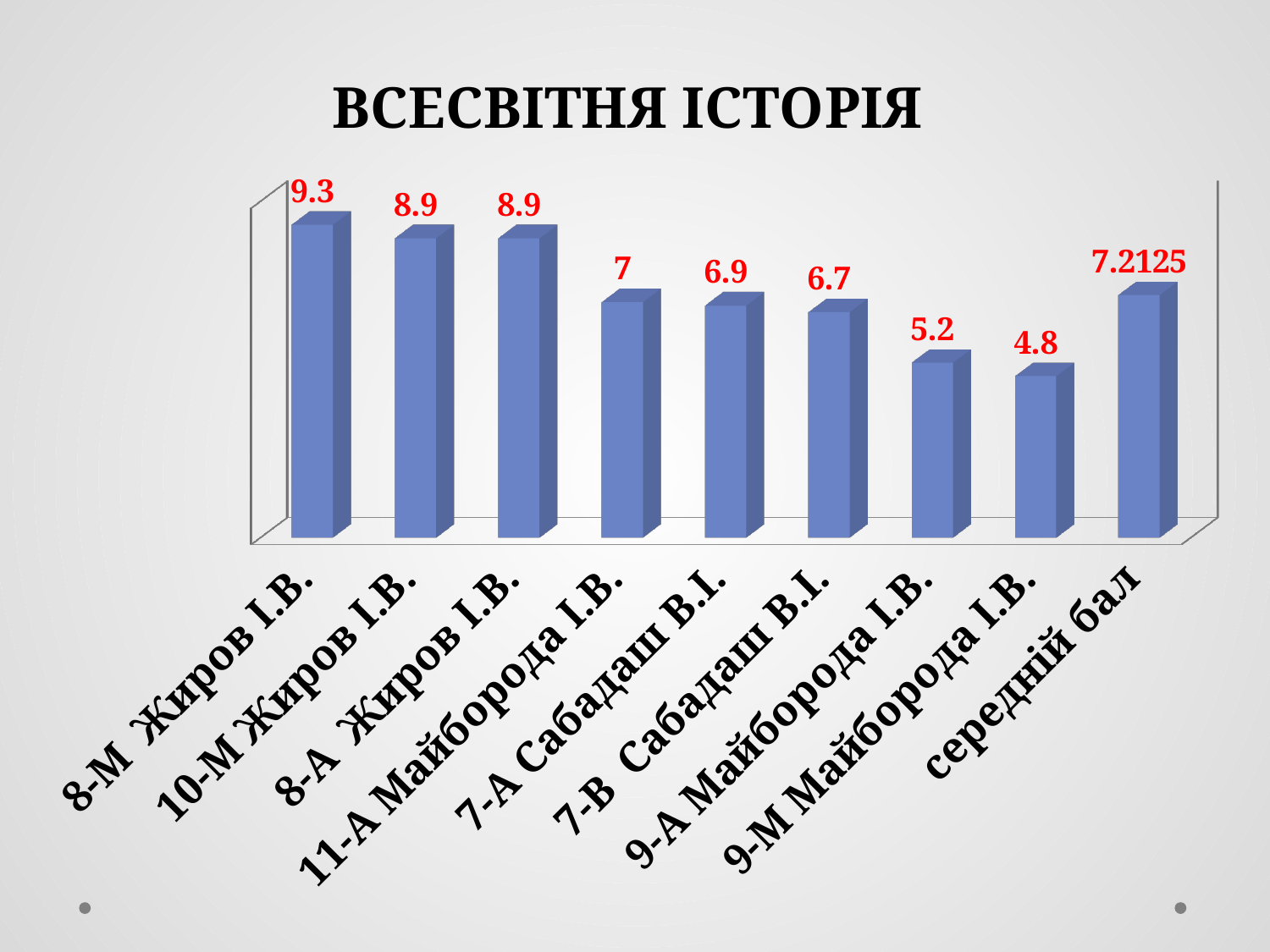
What is the value for 11-А Майборода І.В.? 7 What is the title of the chart? ВСЕСВІТНЯ ІСТОРІЯ What is the value for 8-М Жиров І.В.? 9.3 What is the value shown for середній бал? 7.2125 What is the difference between the values for 7-А Сабадаш В.І. and 9-А Майборода І.В.? 1.7 How many bars are shown in the chart? 9 Which is larger, the value for 10-М Жиров І.В. or the value for 7-А Сабадаш В.І.? 10-М Жиров І.В. What kind of chart is shown on the slide? bar chart Which category has the highest value? 8-М Жиров І.В. What is the value for 7-В Сабадаш В.І.? 6.7 What is the difference between the values for 8-М Жиров І.В. and 9-М Майборода І.В.? 4.5 Which category has the lowest value? 9-М Майборода І.В.